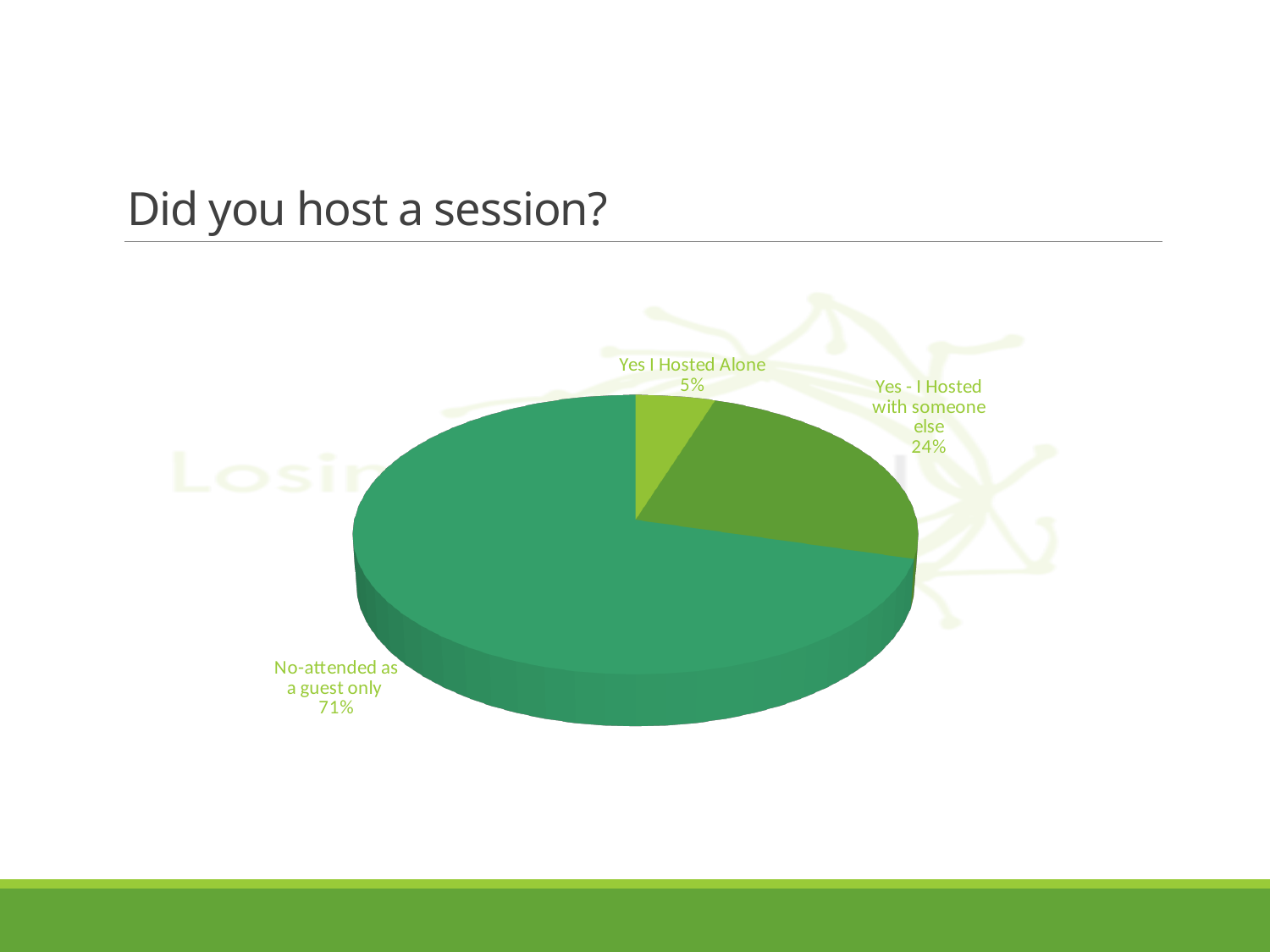
Which category has the largest slice of the pie? No-attended as a guest only What share of respondents answered "Yes - I Hosted with someone else"? 24% Which is larger: the share for "Yes - I Hosted with someone else" or the share for "Yes I Hosted Alone"? Yes - I Hosted with someone else What is the title of the slide containing the pie chart? Did you host a session? What share of respondents answered "No-attended as a guest only"? 71% Which category has the smallest slice of the pie? Yes I Hosted Alone How many categories are shown in the pie chart? 3 What is the difference in percentage points between "Yes - I Hosted with someone else" and "Yes I Hosted Alone"? 19 What kind of chart is shown on the slide? Pie chart What is the combined share of respondents who hosted a session (alone or with someone else)? 29% What is the difference in percentage points between "No-attended as a guest only" and "Yes - I Hosted with someone else"? 47 What share of respondents answered "Yes I Hosted Alone"? 5%